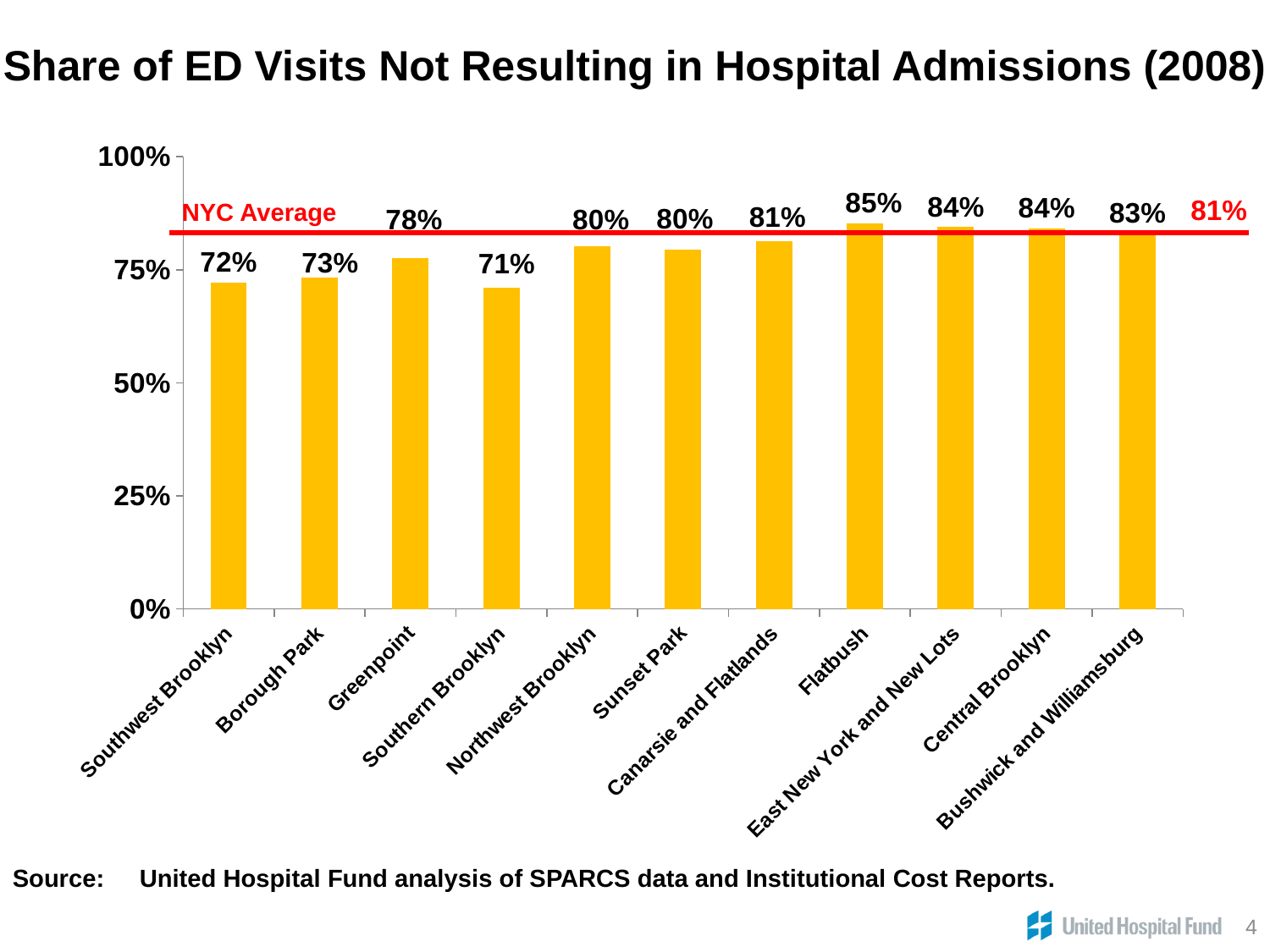
Is the value for Southwest Brooklyn greater or less than 75%? less What kind of chart is shown on the slide? Bar chart Which is larger, the value for Greenpoint or the value for Borough Park? Greenpoint What is the difference between the values for Flatbush and Southern Brooklyn? 14 percentage points What colour are the bars on the chart? Yellow What value is shown for the NYC Average line? 81% What is the value for Greenpoint? 78% Which neighborhood has the highest share of ED visits not resulting in hospital admissions? Flatbush How many neighborhoods are shown on the chart? 11 What is the value for Bushwick and Williamsburg? 83% Which neighborhood has the lowest share of ED visits not resulting in hospital admissions? Southern Brooklyn What is the value for Flatbush? 85%